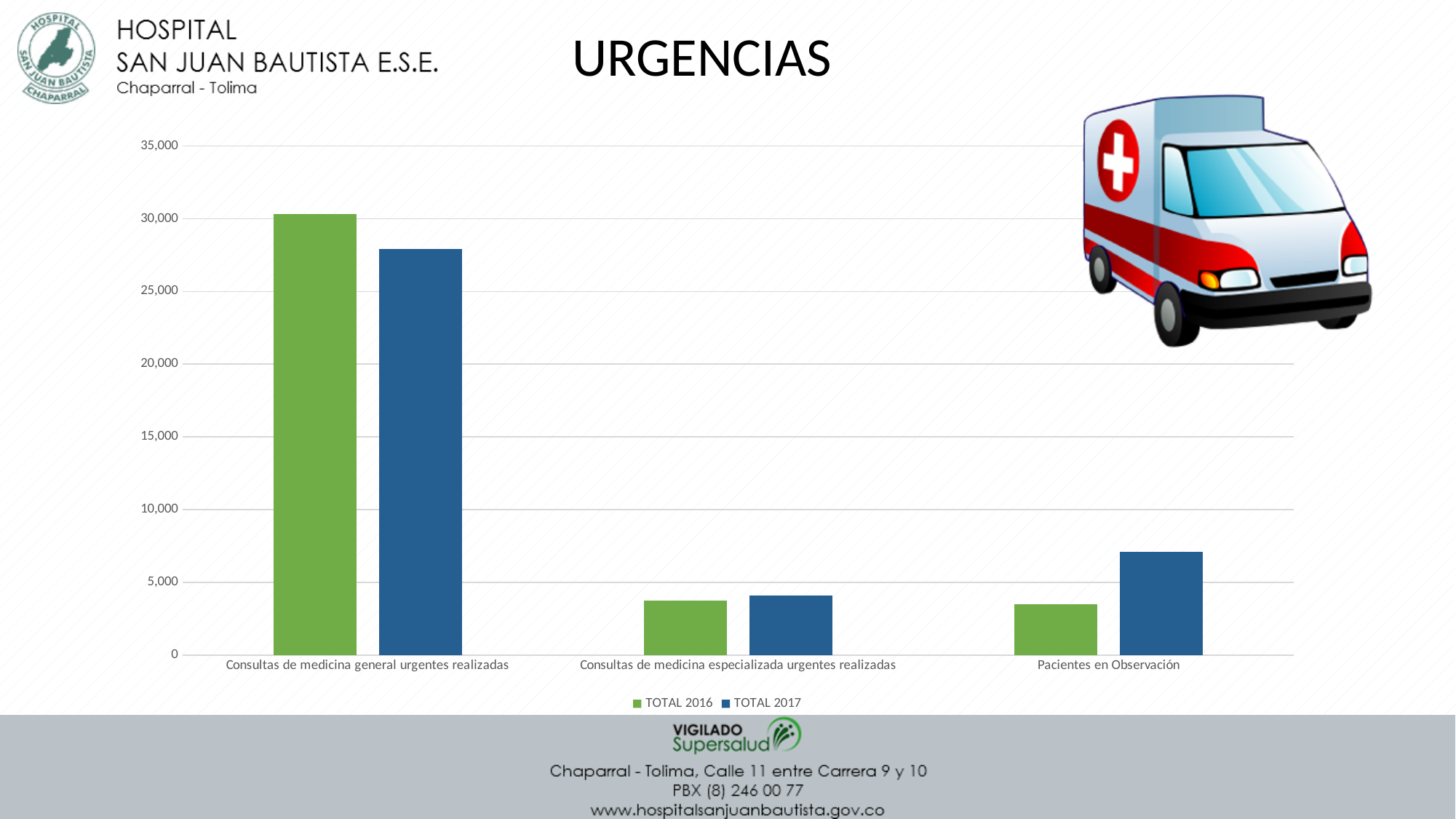
Is the TOTAL 2016 value for Consultas de medicina general urgentes realizadas greater or less than 25,000? greater Is the TOTAL 2016 value for Consultas de medicina especializada urgentes realizadas greater or less than 5,000? less For Pacientes en Observación, which is larger: TOTAL 2016 or TOTAL 2017? TOTAL 2017 Which category has the lowest value for TOTAL 2017? Consultas de medicina especializada urgentes realizadas What is the title shown above the chart? URGENCIAS What kind of chart is shown on the slide? bar chart For Consultas de medicina general urgentes realizadas, which is larger: TOTAL 2016 or TOTAL 2017? TOTAL 2016 How many series does the legend list? 2 Which category has the highest value for TOTAL 2016? Consultas de medicina general urgentes realizadas Is the TOTAL 2017 value for Pacientes en Observación greater or less than 5,000? greater How many categories are shown on the x axis? 3